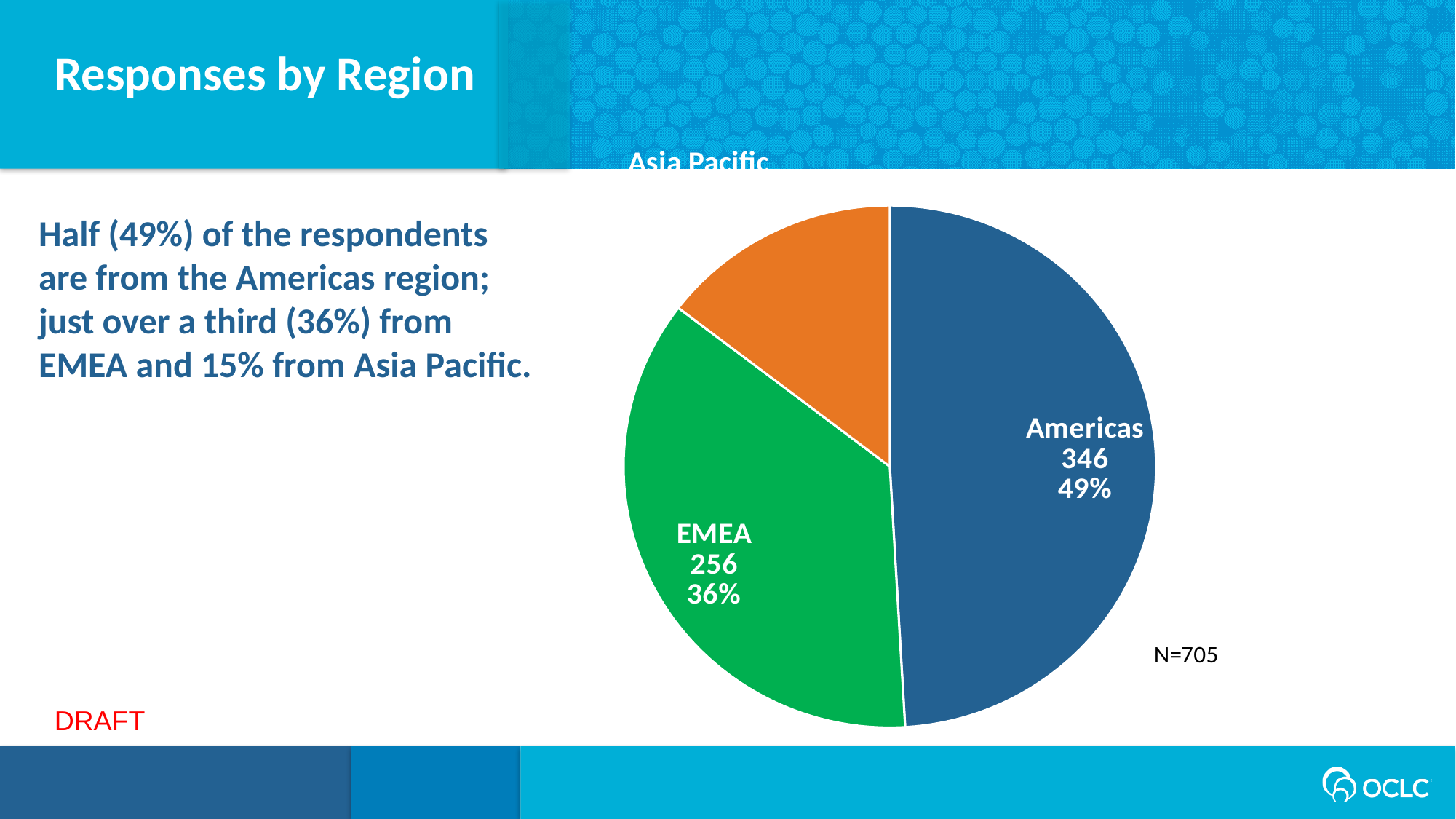
What is the total number of respondents (N) shown on the chart? N=705 Which region has the largest slice of the pie? Americas What is the difference in number of responses between the Americas and EMEA? 90 What is the title of the slide containing the pie chart? Responses by Region What type of chart is shown on the slide? pie chart How many slices does the pie chart have? 3 How many responses came from the EMEA region? 256 Which region has more responses, EMEA or Asia Pacific? EMEA What share of the pie does the Americas slice represent? 49% Which region has the smallest slice of the pie? Asia Pacific How many responses came from the Americas region? 346 What share of the pie does the EMEA slice represent? 36%